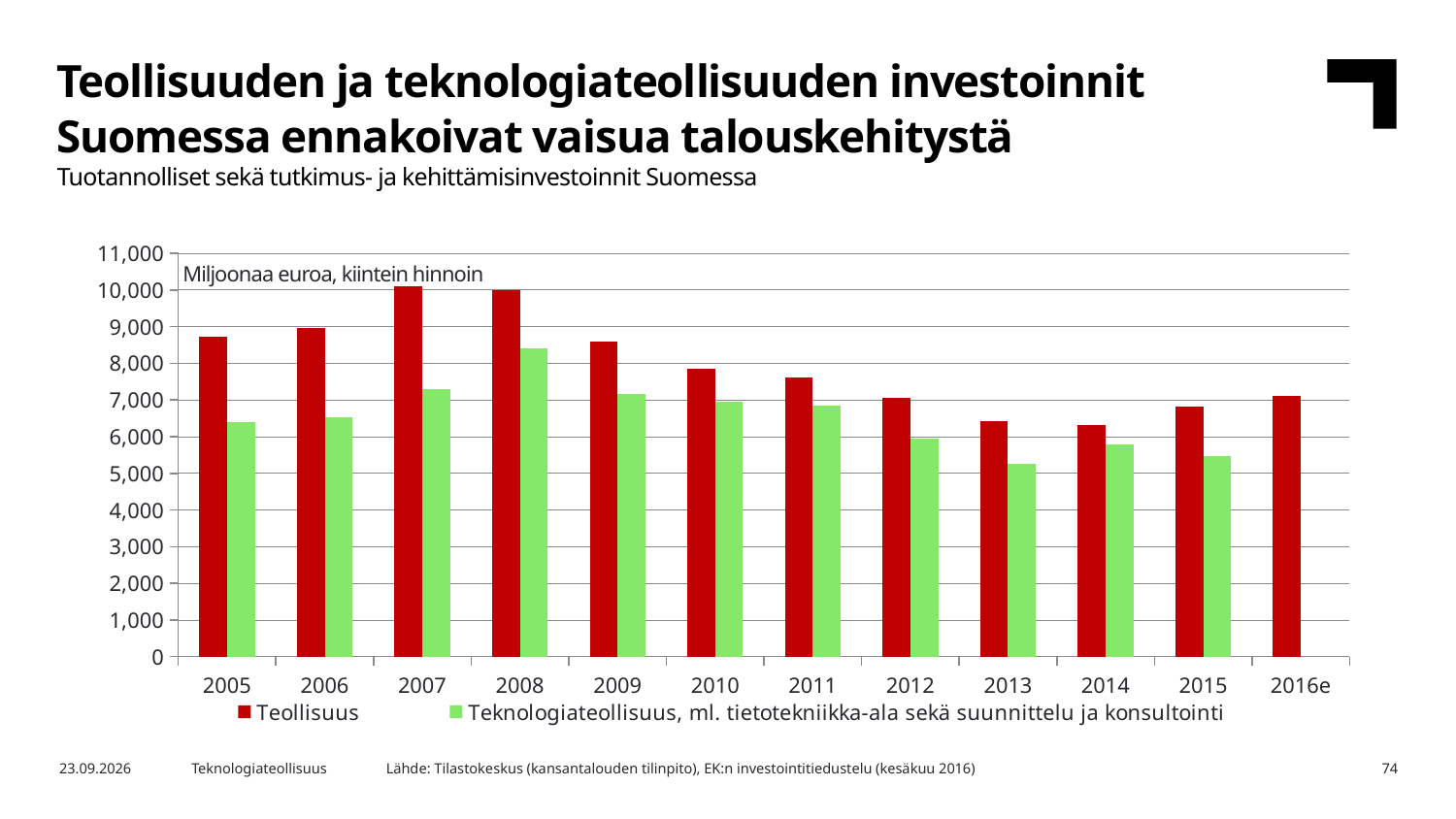
In which year is the Teknologiateollisuus value lowest? 2013 How many series does the legend list? 2 Is the Teollisuus value for 2005 greater or less than 8,000? greater Is the Teollisuus value for 2010 greater or less than 8,000? less Is the Teknologiateollisuus value for 2008 greater or less than 8,000? greater Does the Teollisuus value rise or fall from 2008 to 2014? Fall In which year is the Teknologiateollisuus value highest? 2008 What kind of chart is shown on the slide? Bar chart How many years are shown on the x axis? 12 What unit is stated in the label inside the chart area? Miljoonaa euroa, kiintein hinnoin In 2008, which series has the larger value, Teollisuus or Teknologiateollisuus? Teollisuus